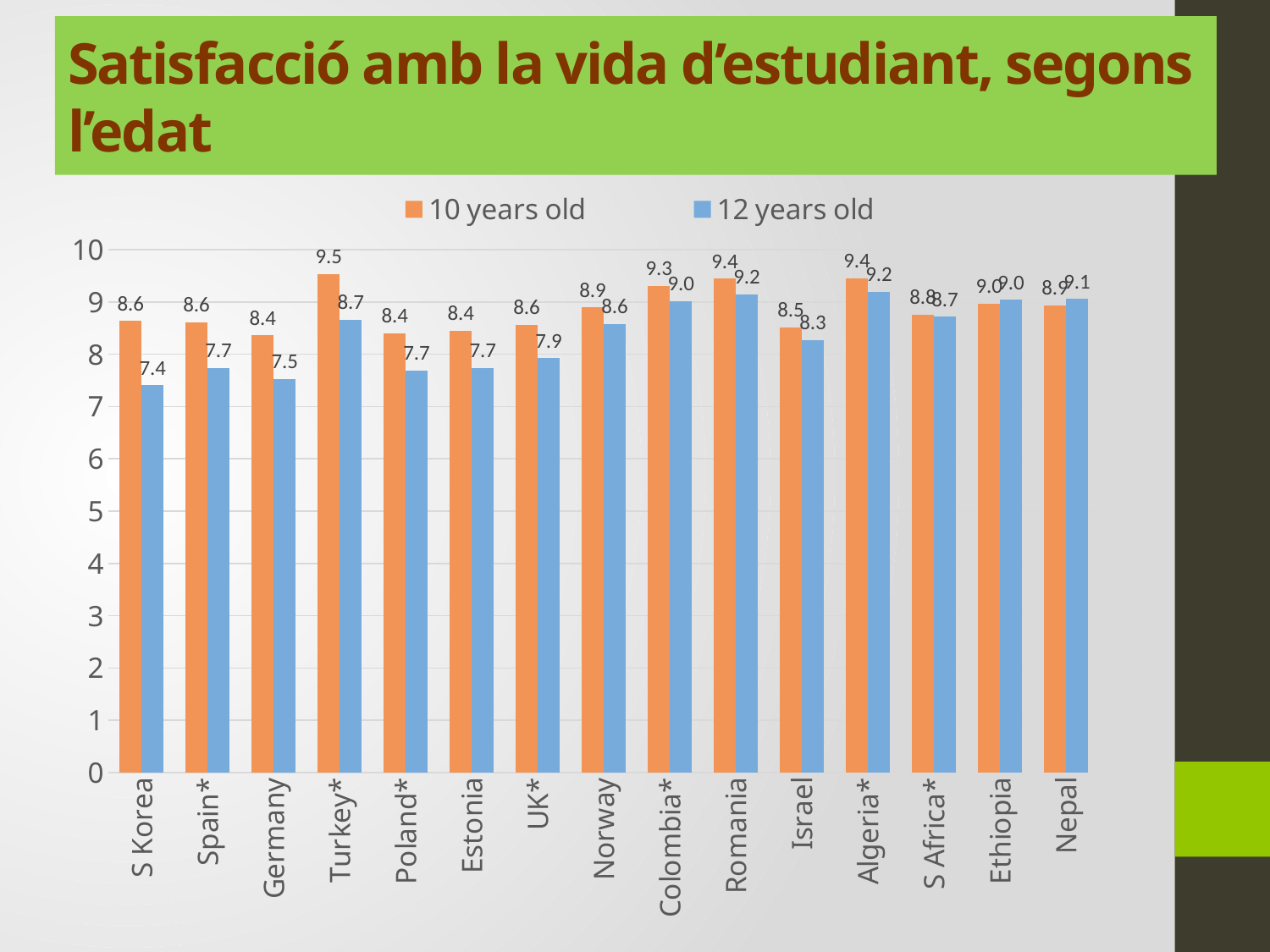
How many series does the legend list? 2 What is the difference between the 10 years old and 12 years old values for S Korea? 1.2 Which country has the highest value in the 10 years old series? Turkey* What is the value for Colombia* in the 12 years old series? 9.0 What is the value for Turkey* in the 10 years old series? 9.5 What is the difference between the 10 years old and 12 years old values for Turkey*? 0.8 What kind of chart is shown on the slide? bar chart Which is larger for Germany: the 10 years old value or the 12 years old value? 10 years old How many countries are shown on the x axis? 15 Is the 12 years old value for Spain* greater or less than 8? less What is the value for S Korea in the 12 years old series? 7.4 Which country has the lowest value in the 12 years old series? S Korea